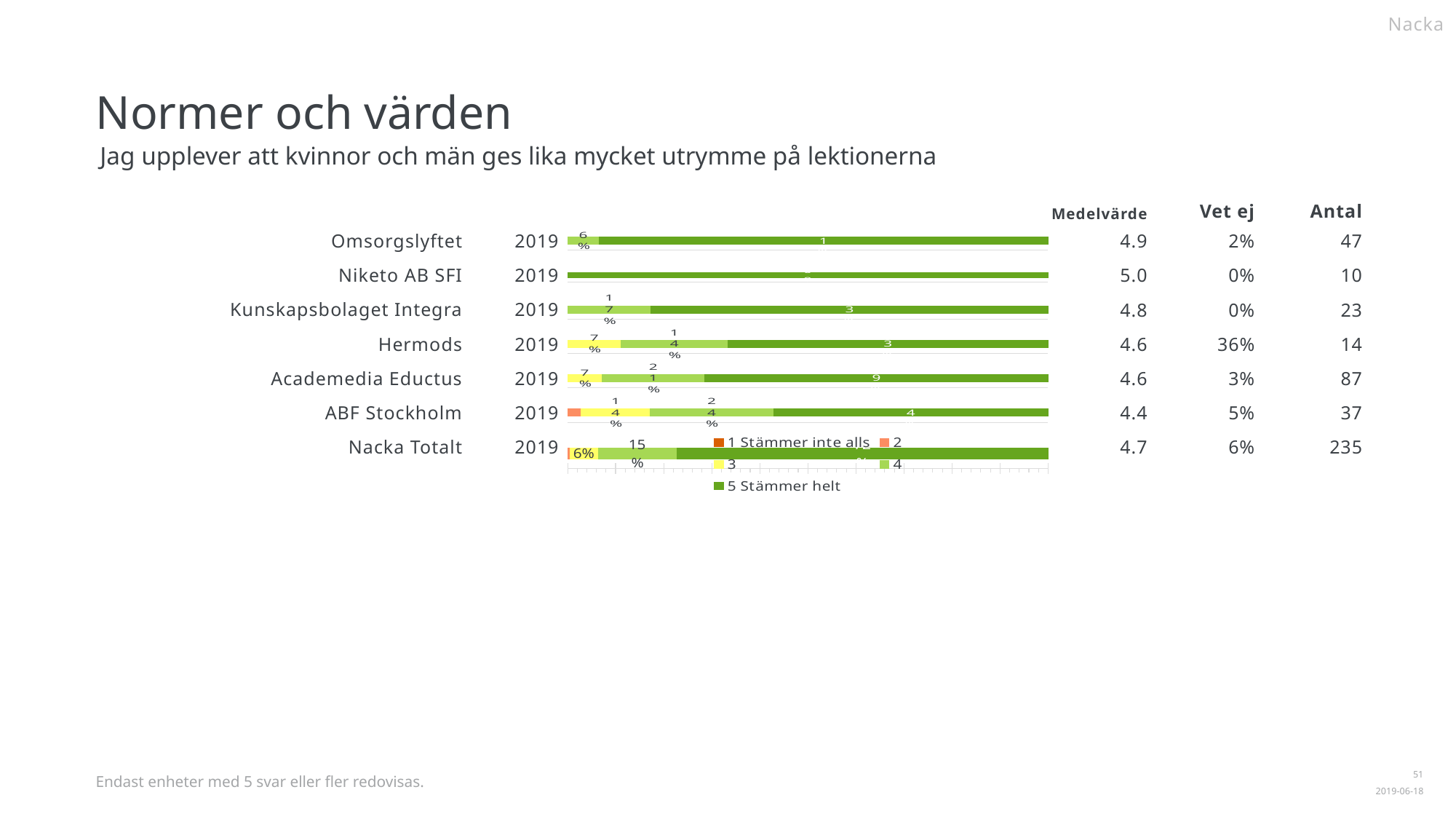
What is the percentage for the '4' segment for Hermods? 14% What is the first entry in the chart legend? 1 Stämmer inte alls What is the percentage for the '4' segment for Academedia Eductus? 21% What is the percentage for the '4' segment for Kunskapsbolaget Integra? 17% What is the percentage for the '4' segment for Omsorgslyftet? 6% What is the percentage for the '3' segment for Hermods? 7% What kind of chart is shown on the slide? bar chart How many series does the chart legend list? 5 What is the percentage for the '4' segment for ABF Stockholm? 24% Which category has the largest '4' segment? ABF Stockholm How many categories (units) are shown in the chart? 7 What is the percentage for the '4' segment for Nacka Totalt? 15%